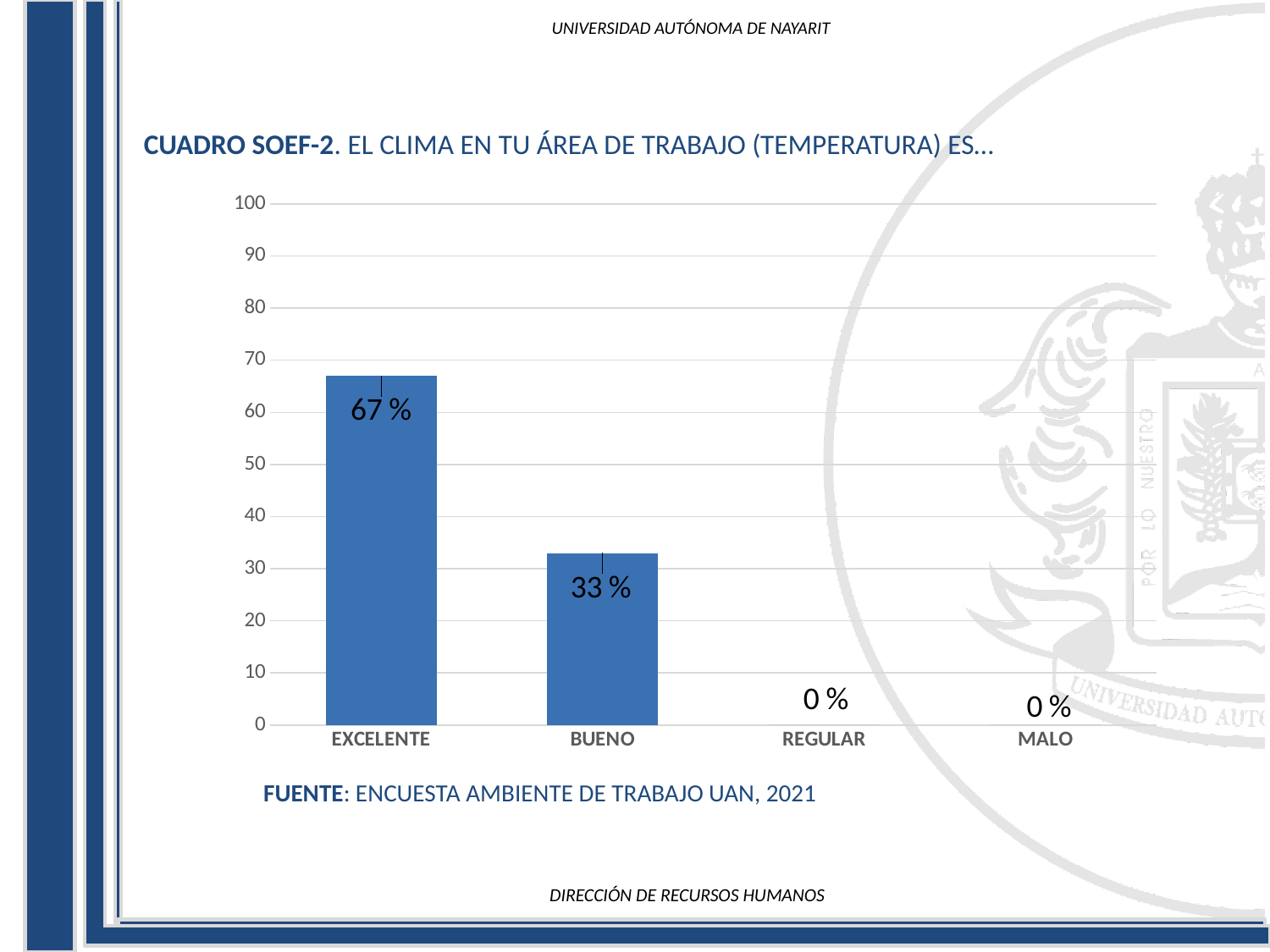
What is the source cited below the chart? ENCUESTA AMBIENTE DE TRABAJO UAN, 2021 Is the value for EXCELENTE greater or less than 60? greater How many categories are shown on the x axis? 4 What kind of chart is shown on the slide? bar chart Which is larger, the value for EXCELENTE or the value for BUENO? EXCELENTE What is the value for MALO? 0 % What is the value for BUENO? 33 % Which category has the highest value? EXCELENTE What is the difference between the values for EXCELENTE and BUENO? 34 % Is the value for BUENO greater or less than 40? less What is the value for REGULAR? 0 % What is the value for EXCELENTE? 67 %